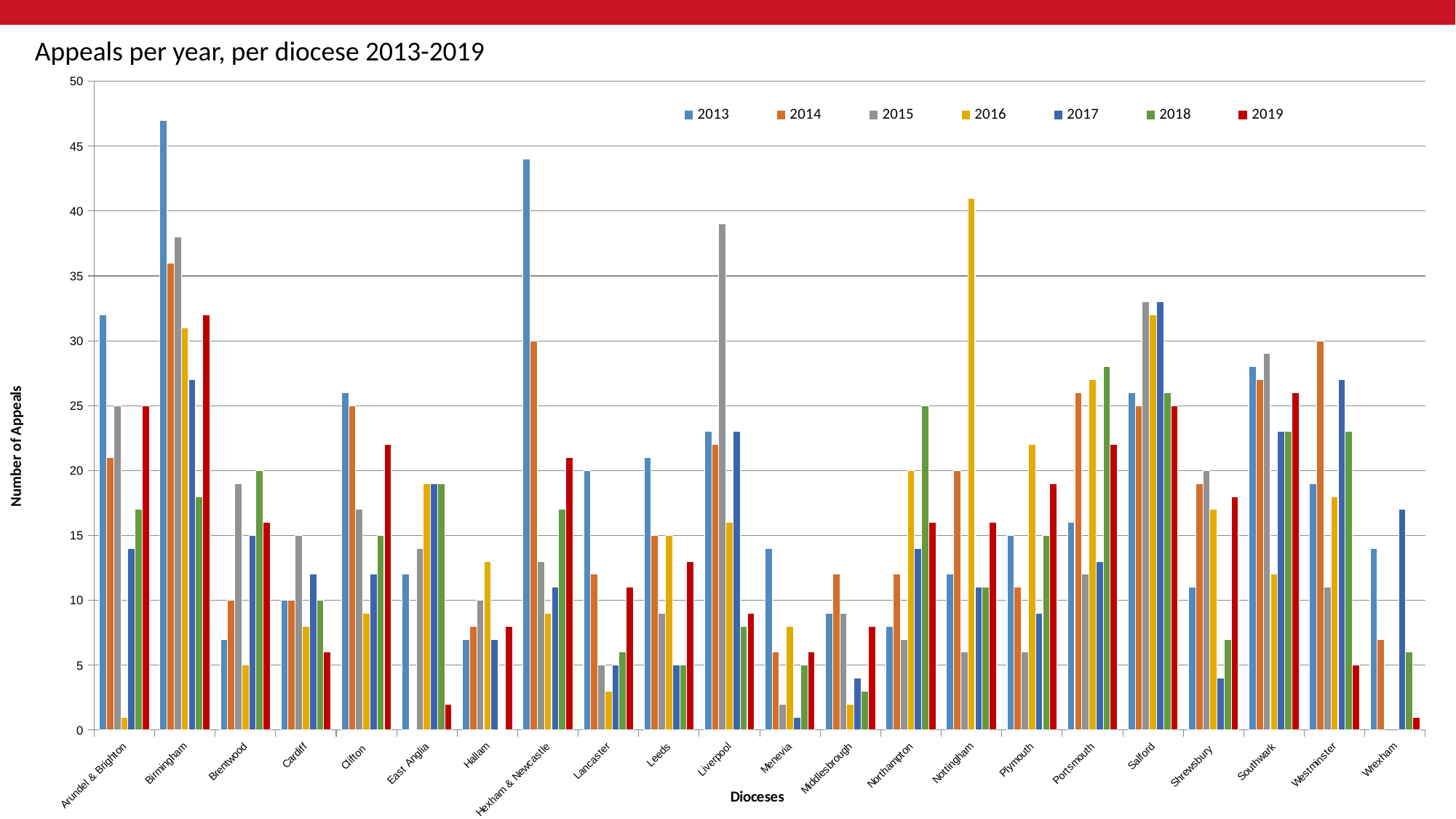
How many series does the legend list? 7 What kind of chart is shown on the slide? bar chart What is the title of the chart? Appeals per year, per diocese 2013-2019 Is the 2013 value for Hexham & Newcastle greater or less than 40? greater Is the 2013 value for Birmingham greater or less than 45? greater How many dioceses are shown along the x axis? 22 What is the label on the vertical axis? Number of Appeals Is the 2014 value for Westminster greater or less than 25? greater Which diocese has the highest 2016 value? Nottingham Which is larger for Westminster, the 2014 value or the 2015 value? 2014 Which year has the highest value for Liverpool? 2015